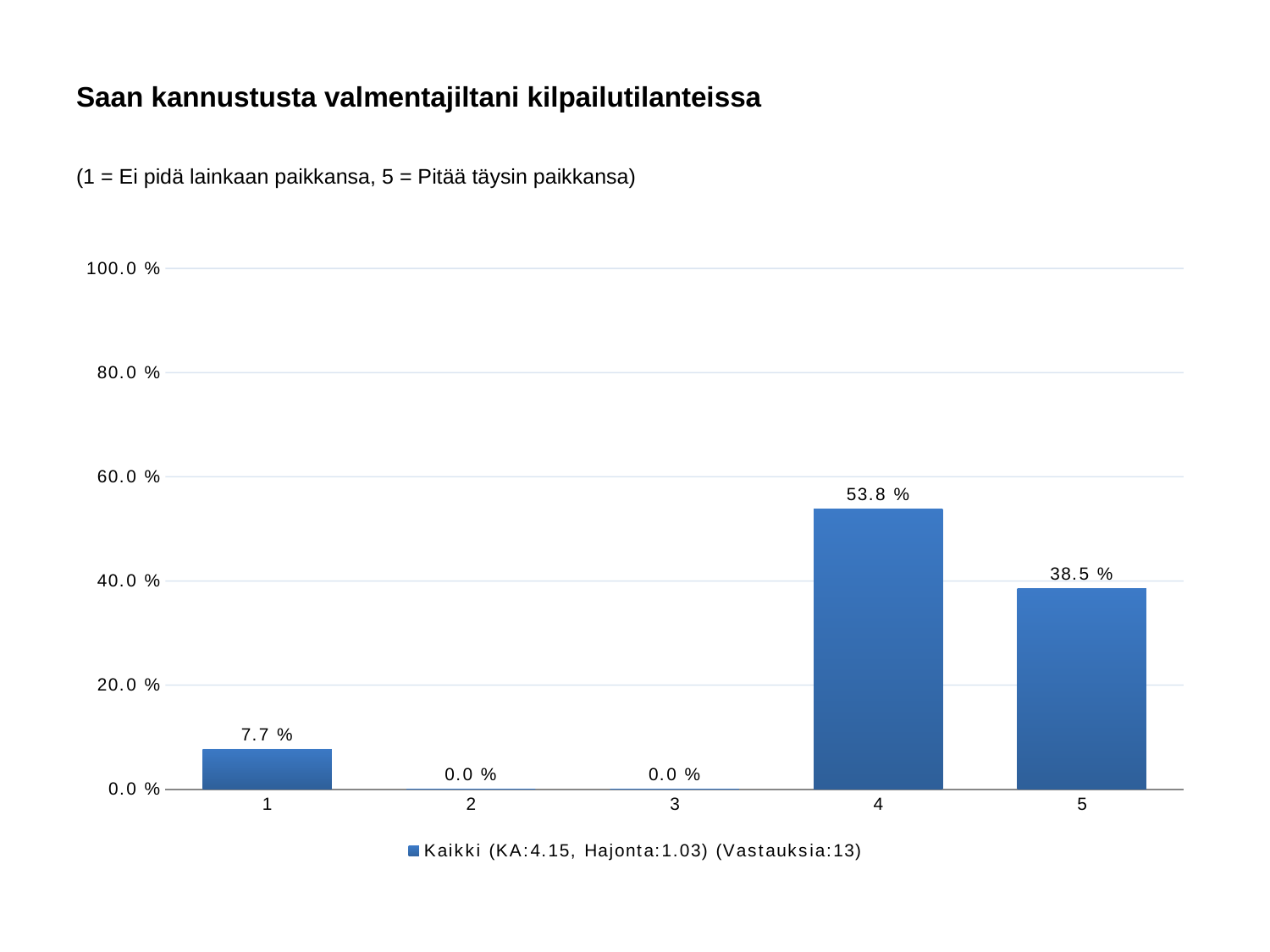
What is the value for category 1? 7.7 % What is the value for category 4? 53.8 % What is the title of the chart? Saan kannustusta valmentajiltani kilpailutilanteissa What is the value for category 2? 0.0 % How many categories are shown on the x axis? 5 What kind of chart is shown on the slide? bar chart How many series does the legend list? 1 Which category has the highest value? 4 Is the value for category 4 greater or less than 40.0 %? greater What is the value for category 5? 38.5 % What is the difference between the values for categories 4 and 5? 15.3 % Which is larger, the value for category 1 or the value for category 5? 5